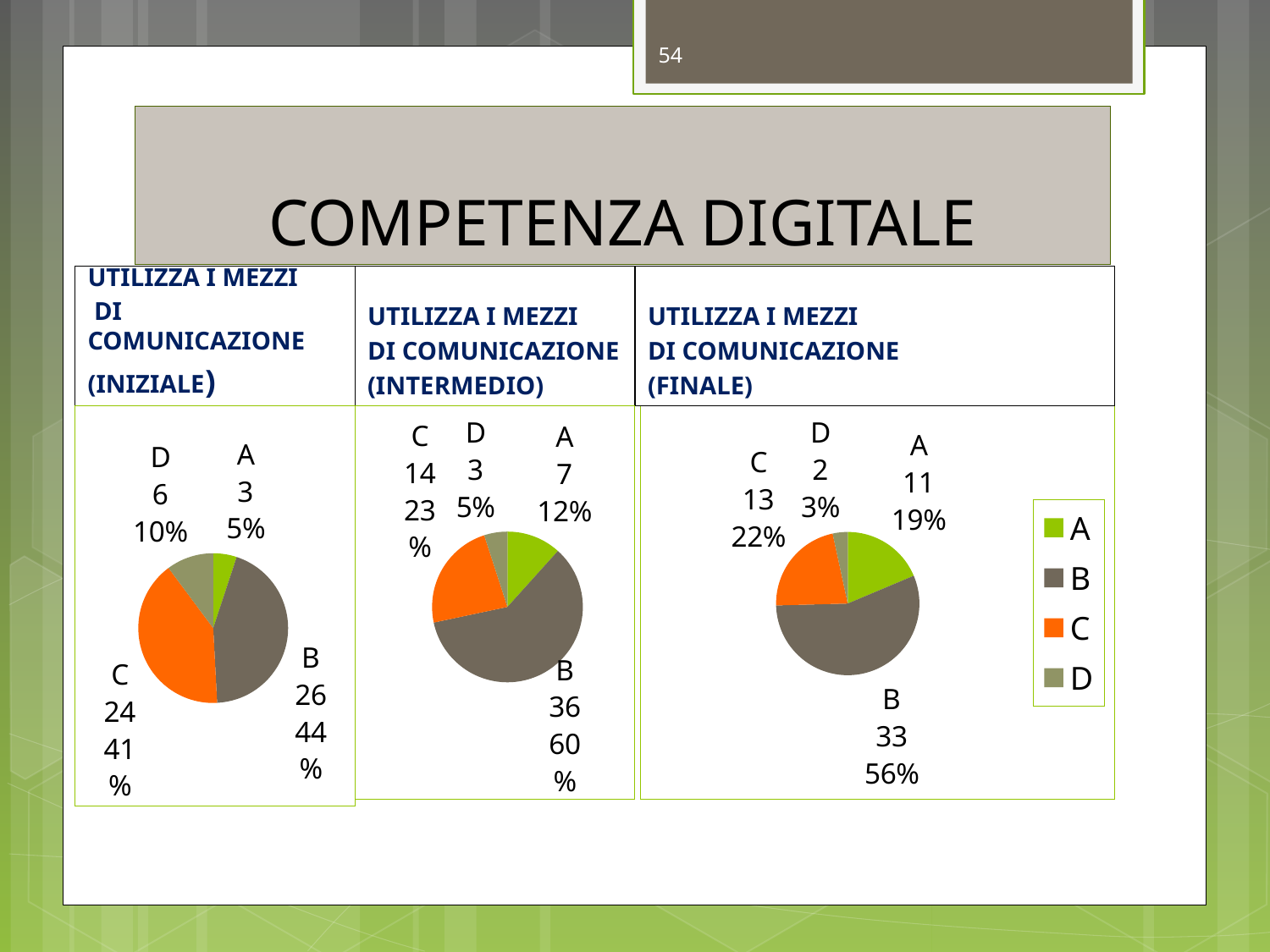
In the FINALE pie chart, what percentage share does category D have? 3% How many categories does the legend on the right of the slide list? 4 What type of chart is used in the INTERMEDIO panel? Pie chart In the FINALE pie chart, what is the difference between the values for B and C? 20 In the INIZIALE pie chart, what percentage share does category C have? 41% In the INIZIALE pie chart, what is the value for category B? 26 In the FINALE pie chart, which is larger, the value for A or the value for C? C In the INTERMEDIO pie chart, what is the value for category B? 36 In the FINALE pie chart, what is the value for category A? 11 In the INTERMEDIO pie chart, what percentage share does category C have? 23% In the INIZIALE pie chart, which category has the smallest value? A In the INTERMEDIO pie chart, which category has the largest value? B